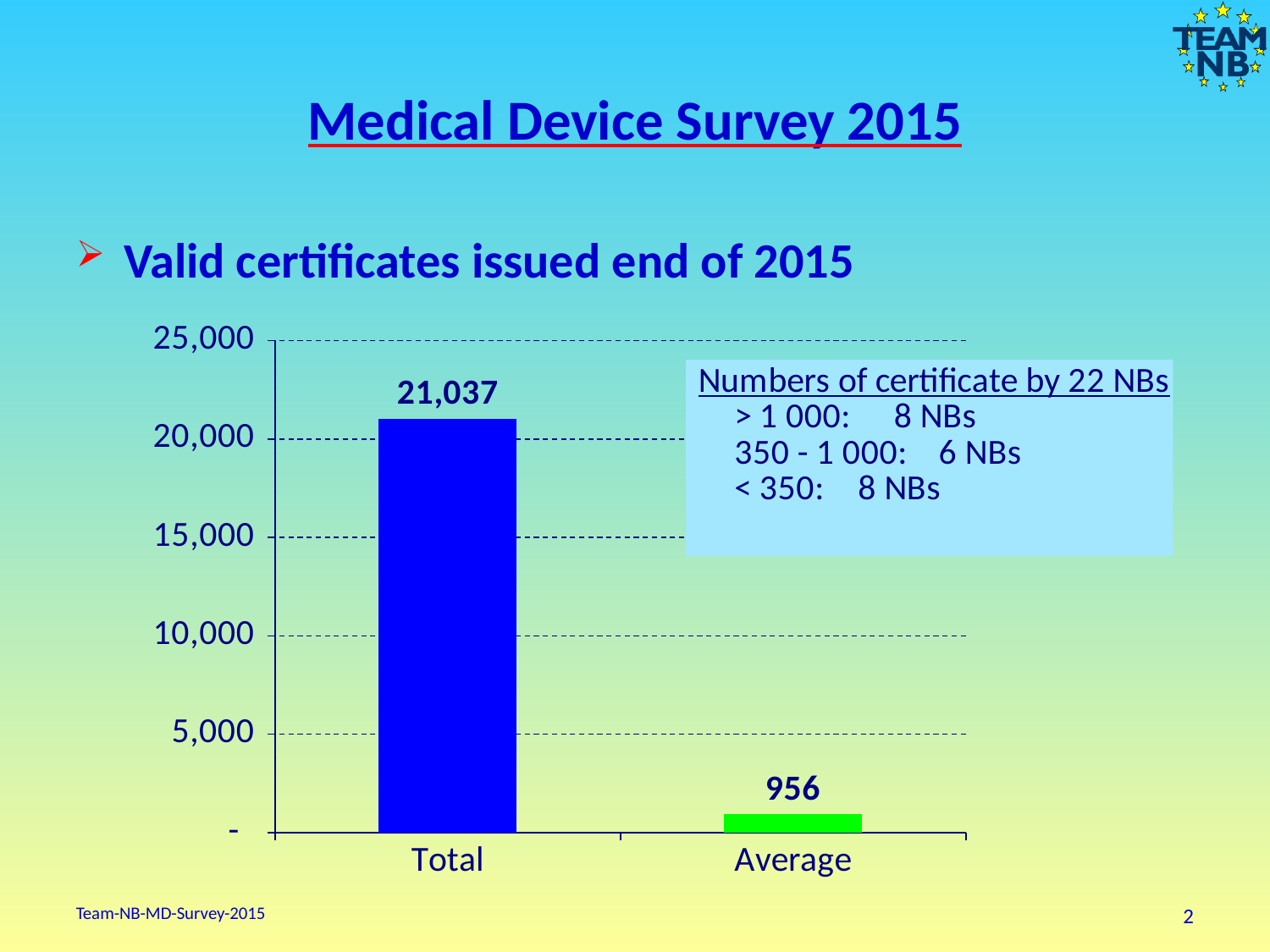
Is the value for Average greater or less than 5,000? less Which category has the lowest value? Average What is the value of the Total bar? 21,037 What colour is the Average bar? Green Is the value for Total greater or less than 20,000? greater Which is larger, the Total bar or the Average bar? Total What is the highest value shown on the y axis? 25,000 Which category has the highest value? Total What is the difference between the Total and Average values? 20,081 What is the value of the Average bar? 956 How many categories are shown on the x axis? 2 What kind of chart is shown on the slide? Bar chart